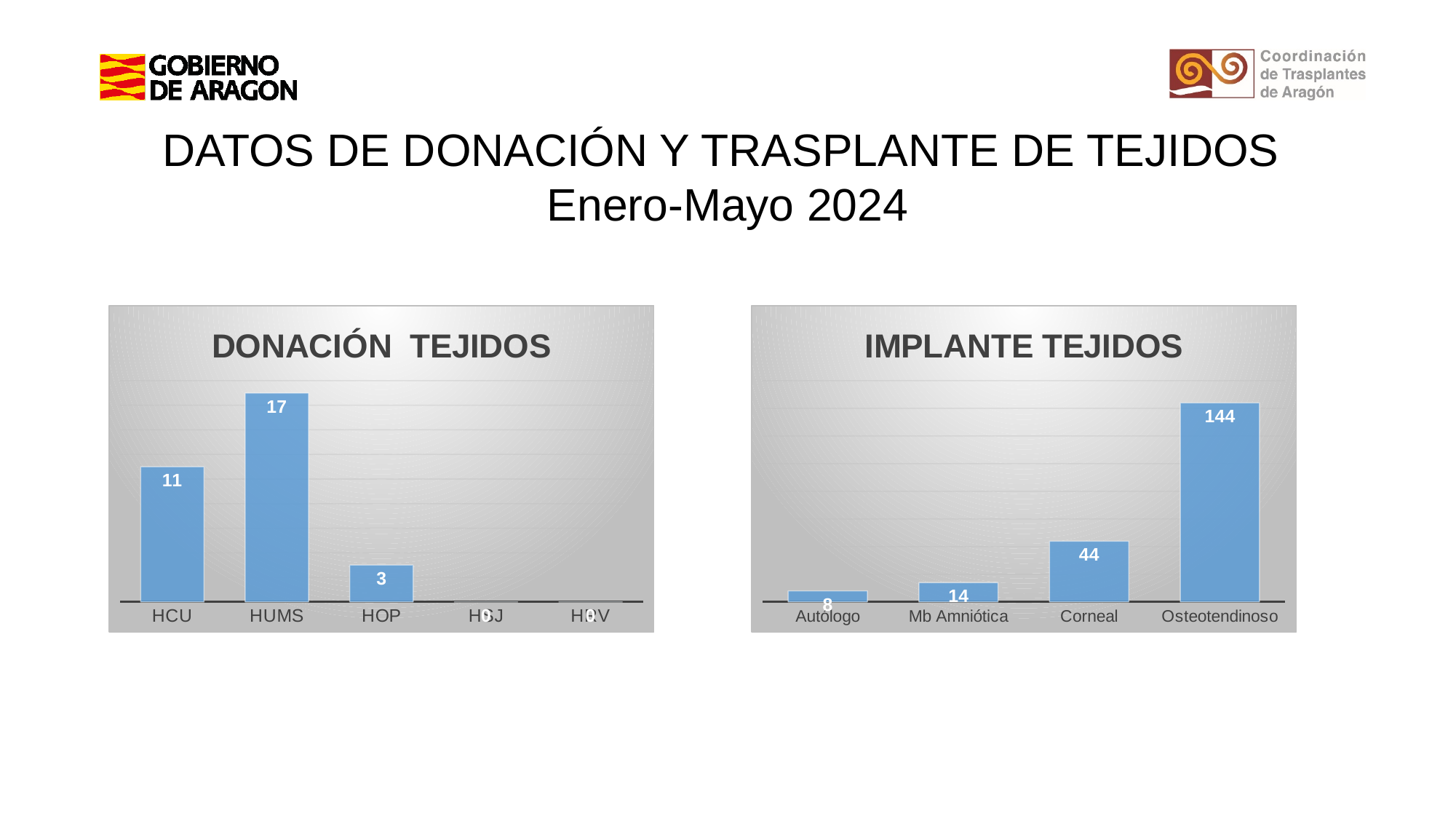
In the IMPLANTE TEJIDOS chart, which is larger, Mb Amniótica or Corneal? Corneal In the DONACIÓN TEJIDOS chart, what is the value for HCU? 11 In the DONACIÓN TEJIDOS chart, how many categories are shown on the x axis? 5 In the IMPLANTE TEJIDOS chart, what is the difference between the values for Osteotendinoso and Corneal? 100 In the IMPLANTE TEJIDOS chart, what is the value for Corneal? 44 In the IMPLANTE TEJIDOS chart, what is the value for Osteotendinoso? 144 In the IMPLANTE TEJIDOS chart, do the values rise or fall from left to right along the x axis? rise In the IMPLANTE TEJIDOS chart, which category has the lowest value? Autólogo In the DONACIÓN TEJIDOS chart, which category has the highest value? HUMS In the DONACIÓN TEJIDOS chart, what is the difference between the values for HUMS and HOP? 14 In the DONACIÓN TEJIDOS chart, what is the value for HUMS? 17 What kind of chart is the IMPLANTE TEJIDOS chart? bar chart